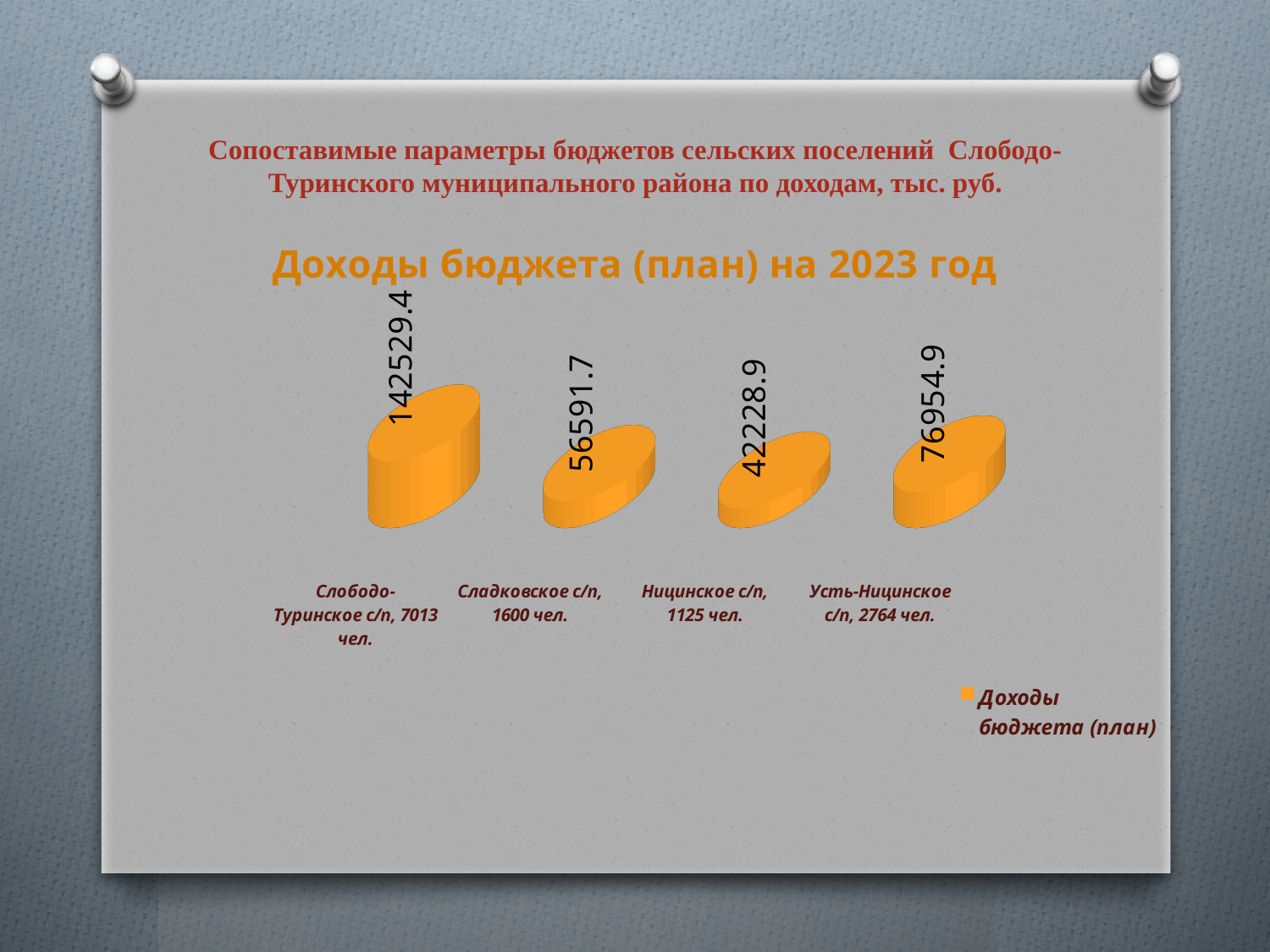
What is the planned budget income for Сладковское с/п? 56591.7 Which settlement has the highest planned budget income? Слободо-Туринское с/п How many series does the legend list? 1 Which has a larger planned budget income, Сладковское с/п or Ницинское с/п? Сладковское с/п What is the planned budget income for Ницинское с/п? 42228.9 What is the planned budget income for Усть-Ницинское с/п? 76954.9 What is the difference between the planned budget income of Усть-Ницинское с/п and Сладковское с/п? 20363.2 What is the title of the chart? Доходы бюджета (план) на 2023 год How many settlements are shown in the chart? 4 What kind of chart is shown on the slide? Bar chart Which settlement has the lowest planned budget income? Ницинское с/п What is the planned budget income for Слободо-Туринское с/п? 142529.4